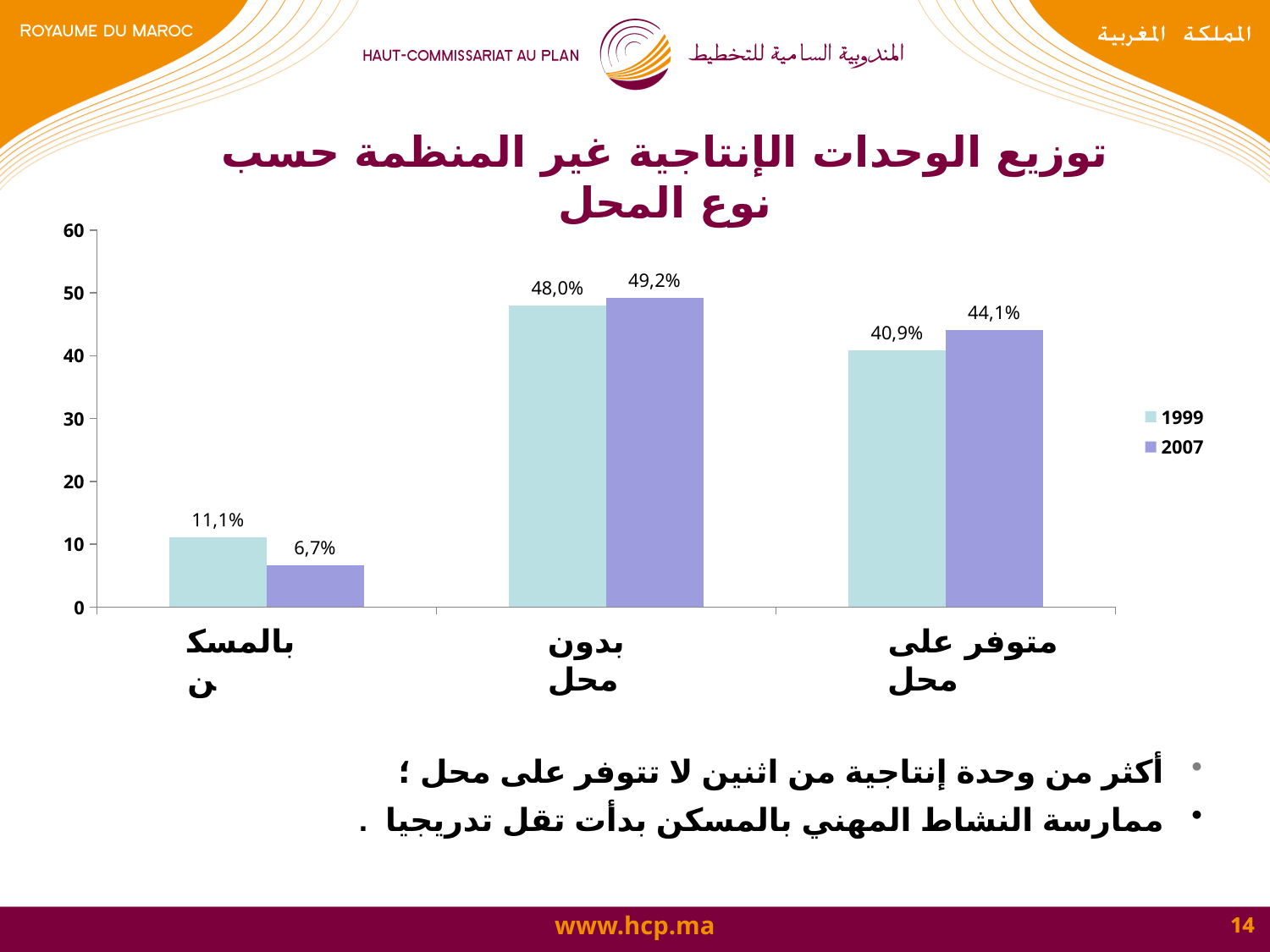
How many series does the legend list? 2 What is the value for بالمسكن in 1999? 11,1% What is the value for بدون محل in 2007? 49,2% How many categories are shown on the x axis? 3 What is the value for بالمسكن in 2007? 6,7% What is the difference between the 2007 and 1999 values for متوفر على محل? 3,2% What kind of chart is shown on the slide? bar chart Which category has the highest value in 2007? بدون محل Which category has the lowest value in 1999? بالمسكن What is the value for متوفر على محل in 1999? 40,9% Which years are listed in the legend? 1999 and 2007 Which is larger for بالمسكن: the 1999 value or the 2007 value? 1999